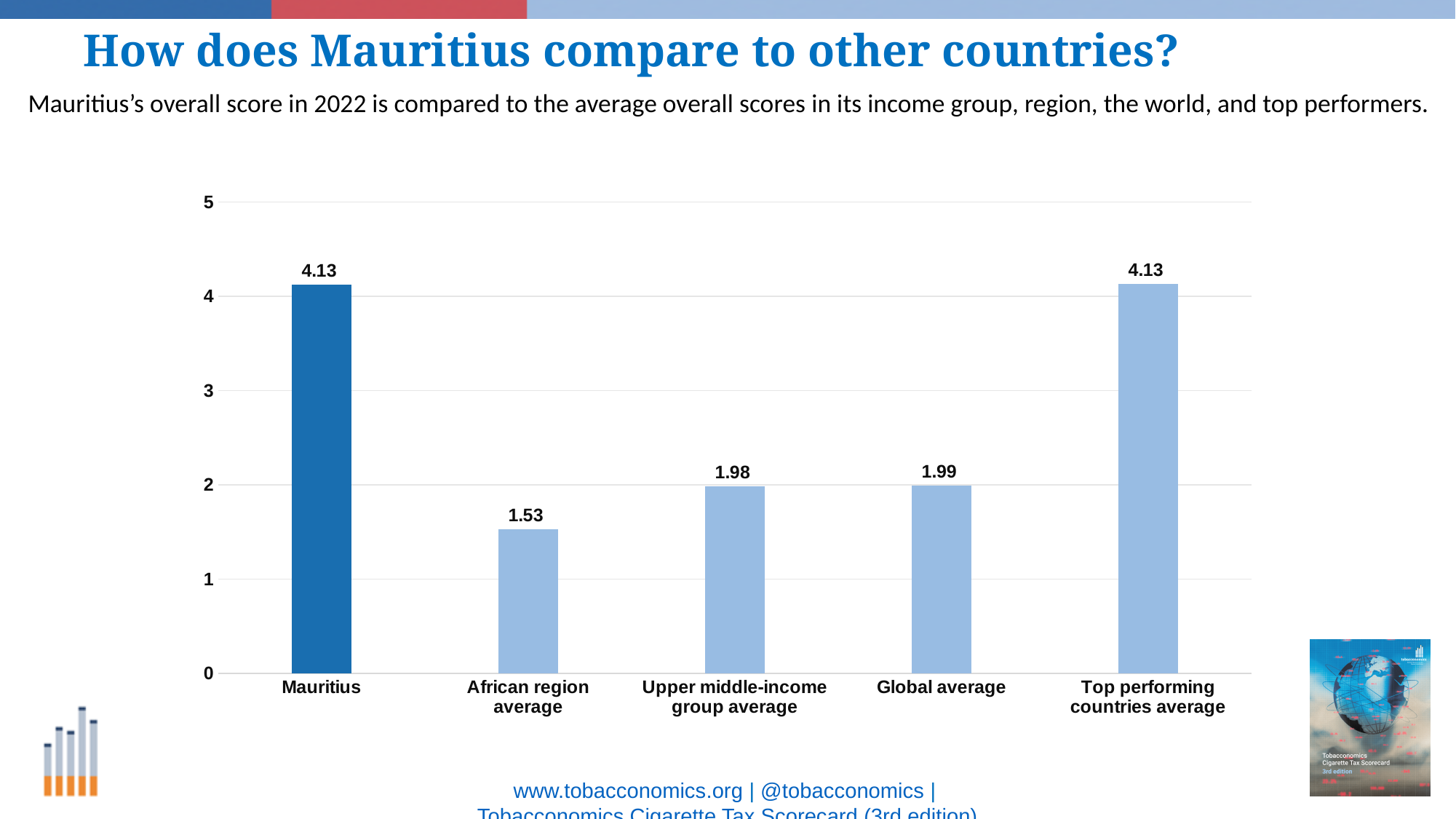
What is the value for the Upper middle-income group average? 1.98 What is the difference between the value for Mauritius and the African region average? 2.60 What is the value for the Global average? 1.99 What is the value for Mauritius? 4.13 What is the difference between the Global average and the Upper middle-income group average? 0.01 Which bar is shown in a darker blue than the others? Mauritius What is the value for the Top performing countries average? 4.13 What is the value for the African region average? 1.53 What kind of chart is shown on the slide? Bar chart How many categories are shown on the chart? 5 Which category has the lowest value? African region average Which is larger, the value for Mauritius or the Global average? Mauritius